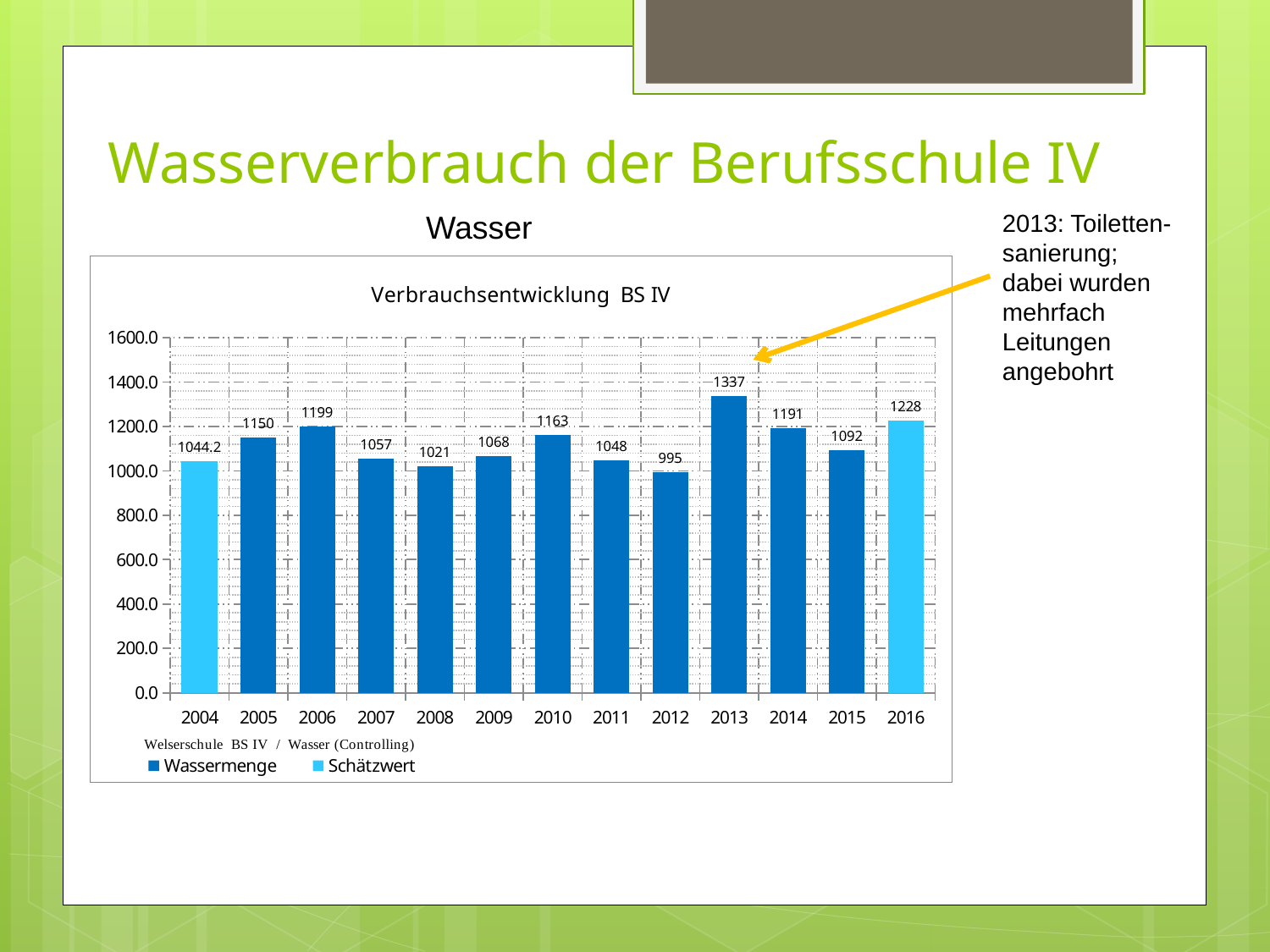
Is the value for 2012 in the Verbrauchsentwicklung BS IV chart greater or less than 1000.0? less Which year has the highest value in the Verbrauchsentwicklung BS IV chart? 2013 What is the value for 2013 in the Verbrauchsentwicklung BS IV chart? 1337 Which year has the lowest value in the Verbrauchsentwicklung BS IV chart? 2012 What is the value for 2016 in the Verbrauchsentwicklung BS IV chart? 1228 How many years are shown on the x axis of the Verbrauchsentwicklung BS IV chart? 13 What kind of chart is the Verbrauchsentwicklung BS IV chart? bar chart Which series in the Verbrauchsentwicklung BS IV chart is shown in light blue? Schätzwert What is the difference between the values for 2013 and 2012 in the Verbrauchsentwicklung BS IV chart? 342 What is the value for 2004 in the Verbrauchsentwicklung BS IV chart? 1044.2 Which is larger in the Verbrauchsentwicklung BS IV chart, the value for 2006 or the value for 2007? 2006 How many series does the legend of the Verbrauchsentwicklung BS IV chart list? 2